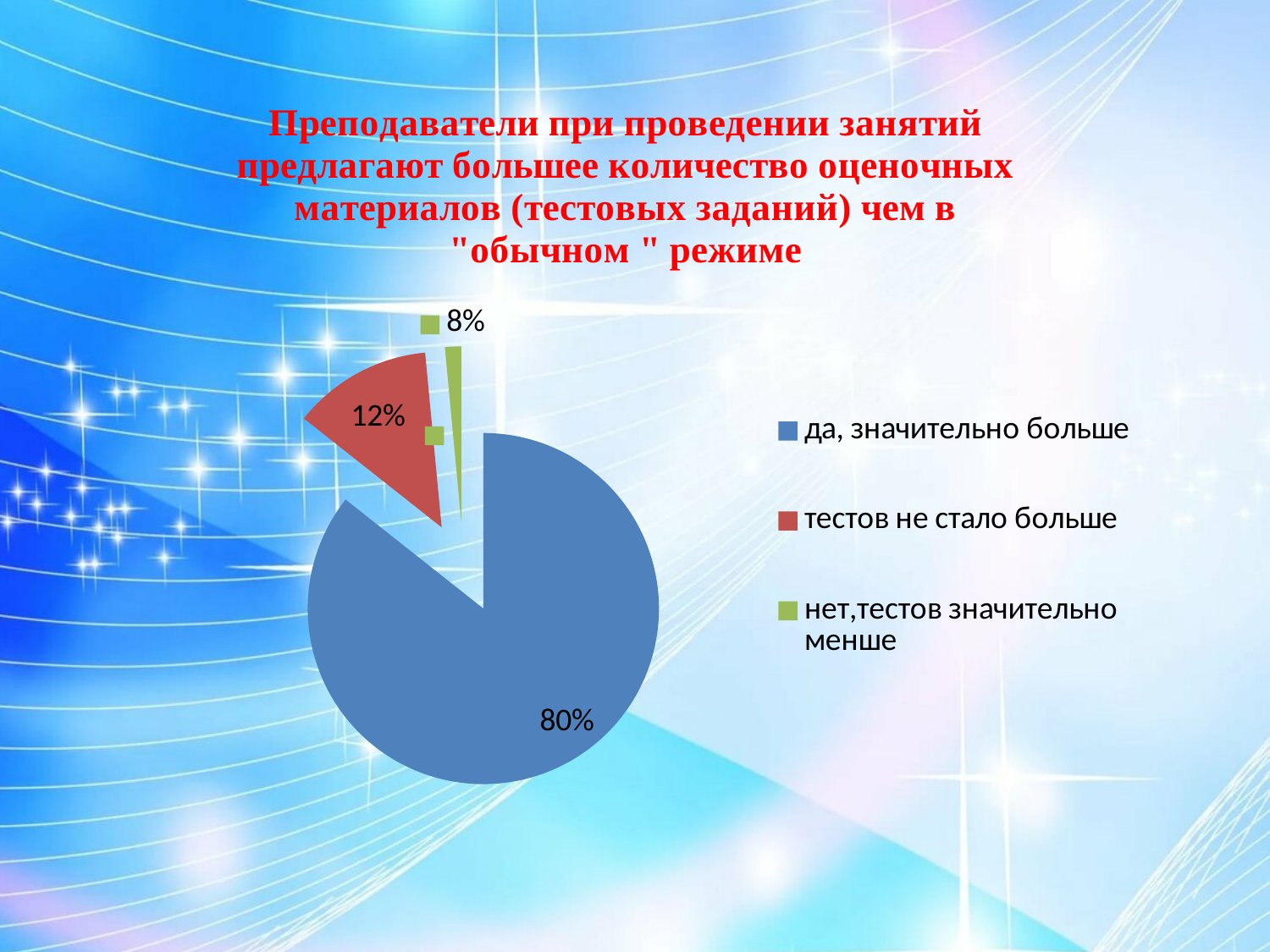
What is the difference in percentage points between "да, значительно больше" and "тестов не стало больше"? 68 Which category has the smallest share of the pie? нет,тестов значительно менше Which category has the largest share of the pie? да, значительно больше What percentage is shown for "тестов не стало больше"? 12% How many entries does the legend list? 3 How many slices does the pie chart have? 3 Which is larger: the share for "тестов не стало больше" or for "нет,тестов значительно менше"? тестов не стало больше What kind of chart is shown on the slide? pie chart What is the difference in percentage points between "тестов не стало больше" and "нет,тестов значительно менше"? 4 What percentage is shown for "да, значительно больше"? 80% What colour is the slice for "да, значительно больше"? blue What percentage is shown for "нет,тестов значительно менше"? 8%